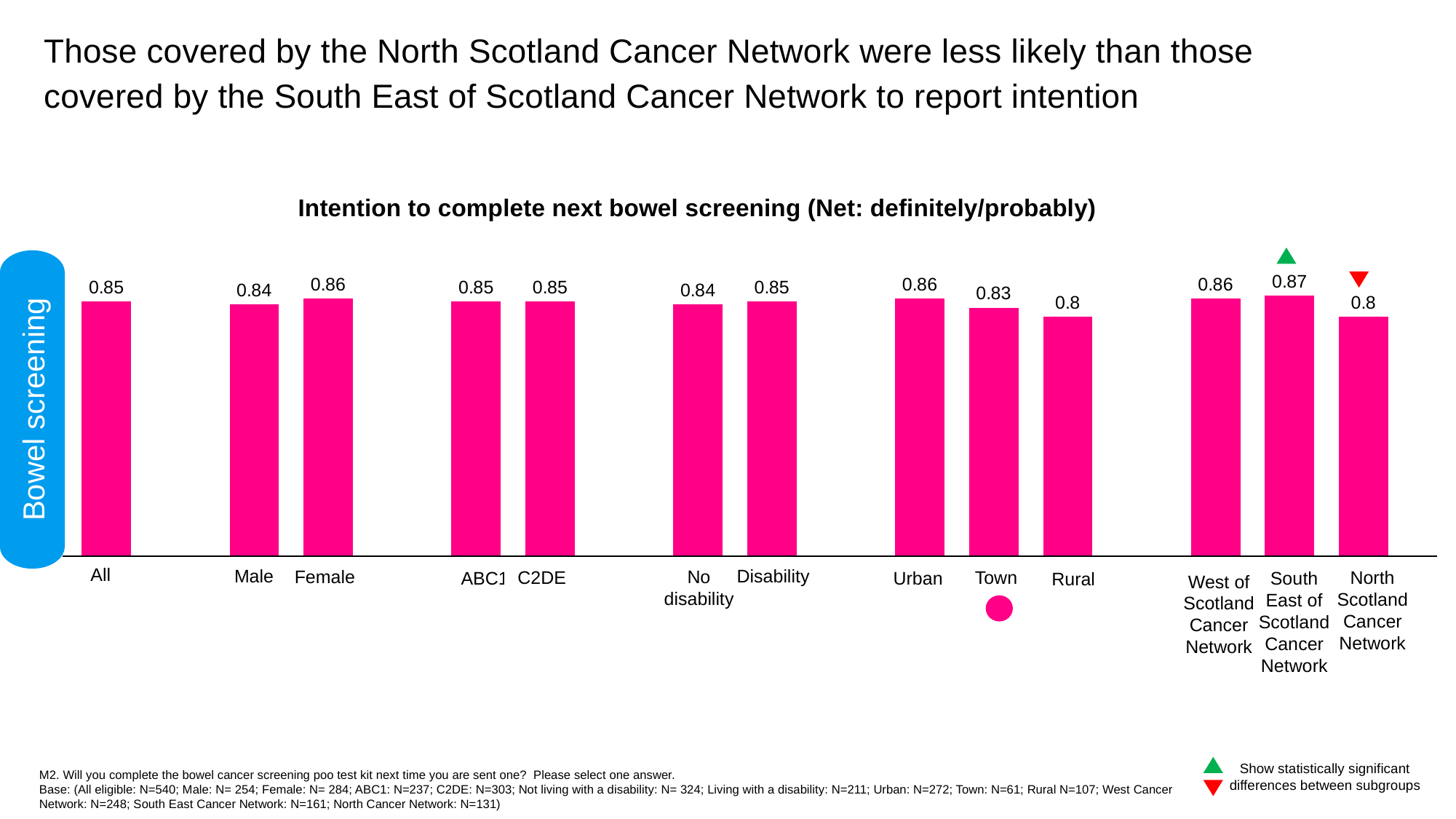
What is the difference between the Urban and Rural values? 0.06 What is the value for Town? 0.83 What is the difference between the South East of Scotland Cancer Network and the North Scotland Cancer Network values? 0.07 Which category has the highest value? South East of Scotland Cancer Network What is the value for All? 0.85 What is the value for No disability? 0.84 How many bars are shown in the chart? 13 What is the title of the chart? Intention to complete next bowel screening (Net: definitely/probably) What kind of chart is shown on the slide? Bar chart What is the value for the South East of Scotland Cancer Network? 0.87 What is the value for Rural? 0.8 Which is larger, the value for Female or the value for Male? Female